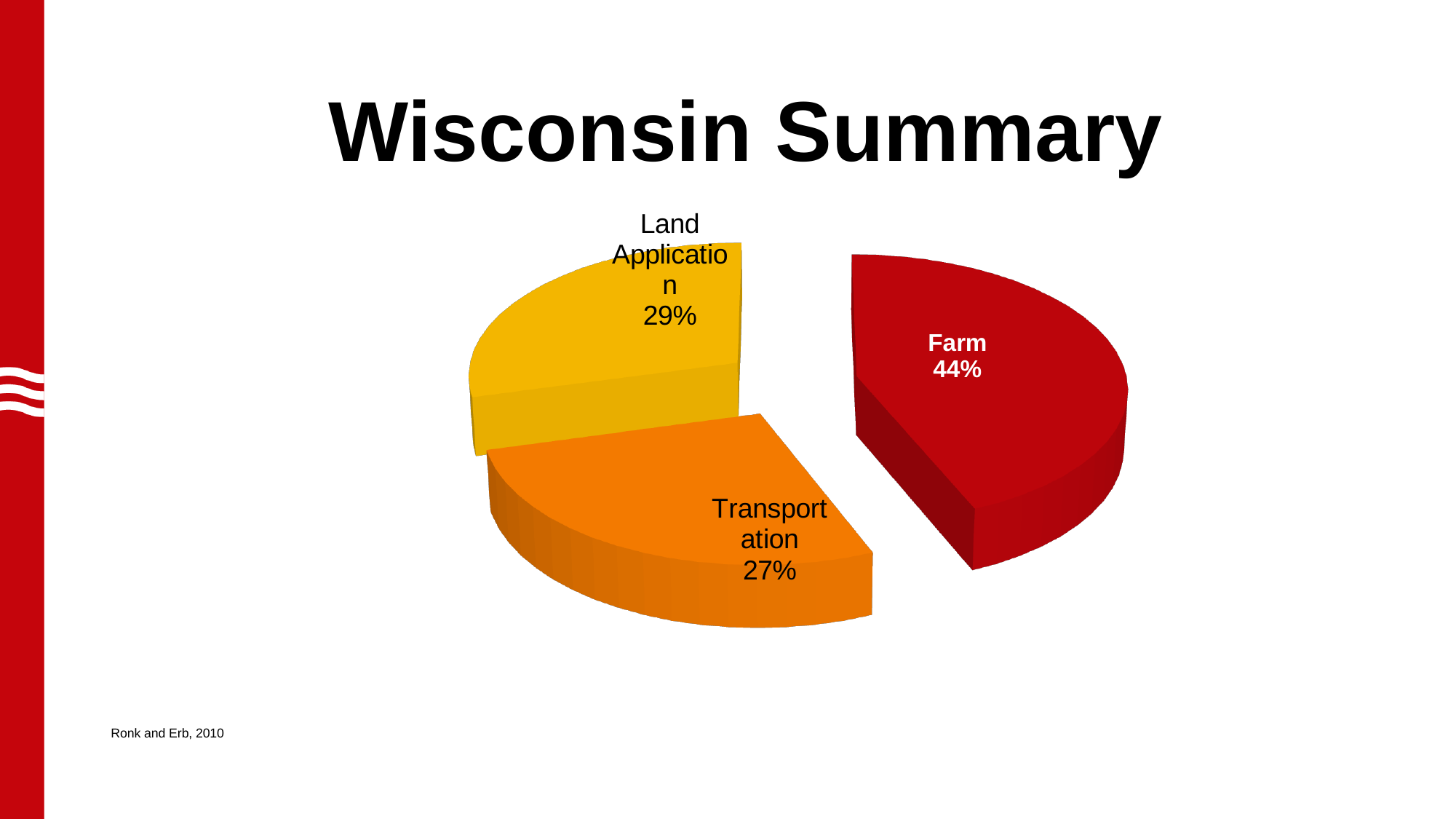
What is the difference in percentage points between Land Application and Transportation? 2 Which category has the largest slice of the pie? Farm How many slices does the pie chart have? 3 What colour is the Farm slice of the pie chart? red Which category has the smallest slice of the pie? Transportation What kind of chart is shown on the slide? pie chart What is the difference in percentage points between Farm and Transportation? 17 What share of the pie does Land Application account for? 29% Which is larger, the Farm slice or the Land Application slice? Farm What is the title of the slide containing the pie chart? Wisconsin Summary What share of the pie does Transportation account for? 27% What share of the pie does Farm account for? 44%